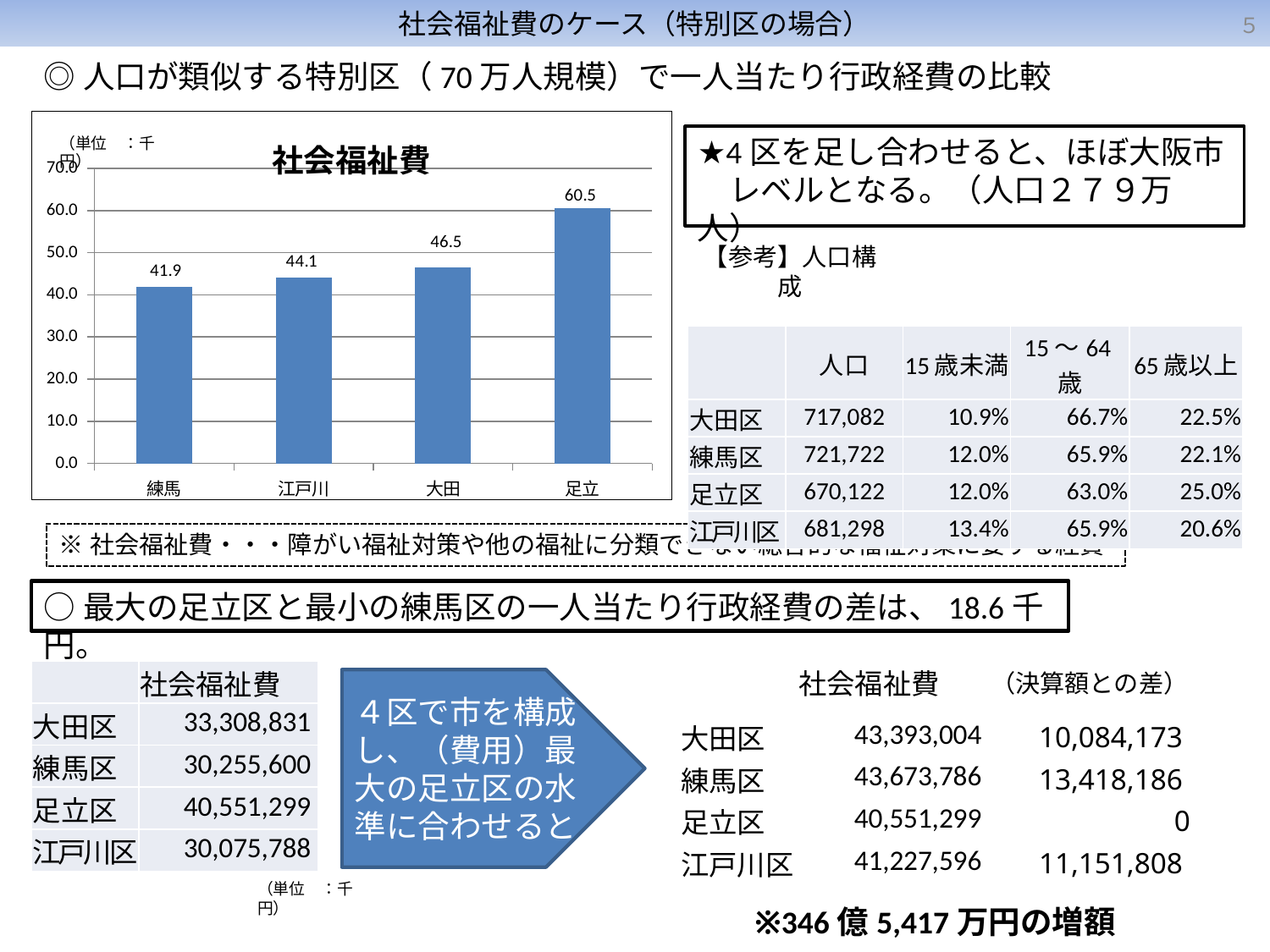
What is the value for 足立 in the 社会福祉費 chart? 60.5 What is the value for 大田 in the 社会福祉費 chart? 46.5 Which category has the highest value in the 社会福祉費 chart? 足立 In the 社会福祉費 chart, which is larger, the value for 大田 or the value for 江戸川? 大田 What is the difference between the values for 足立 and 練馬 in the 社会福祉費 chart? 18.6 How many categories are shown in the 社会福祉費 chart? 4 What is the value for 江戸川 in the 社会福祉費 chart? 44.1 What type of chart is the 社会福祉費 chart? bar chart What unit is indicated for the values in the 社会福祉費 chart? 千円 What is the value for 練馬 in the 社会福祉費 chart? 41.9 Is the value for 足立 in the 社会福祉費 chart greater or less than 50.0? greater Which category has the lowest value in the 社会福祉費 chart? 練馬